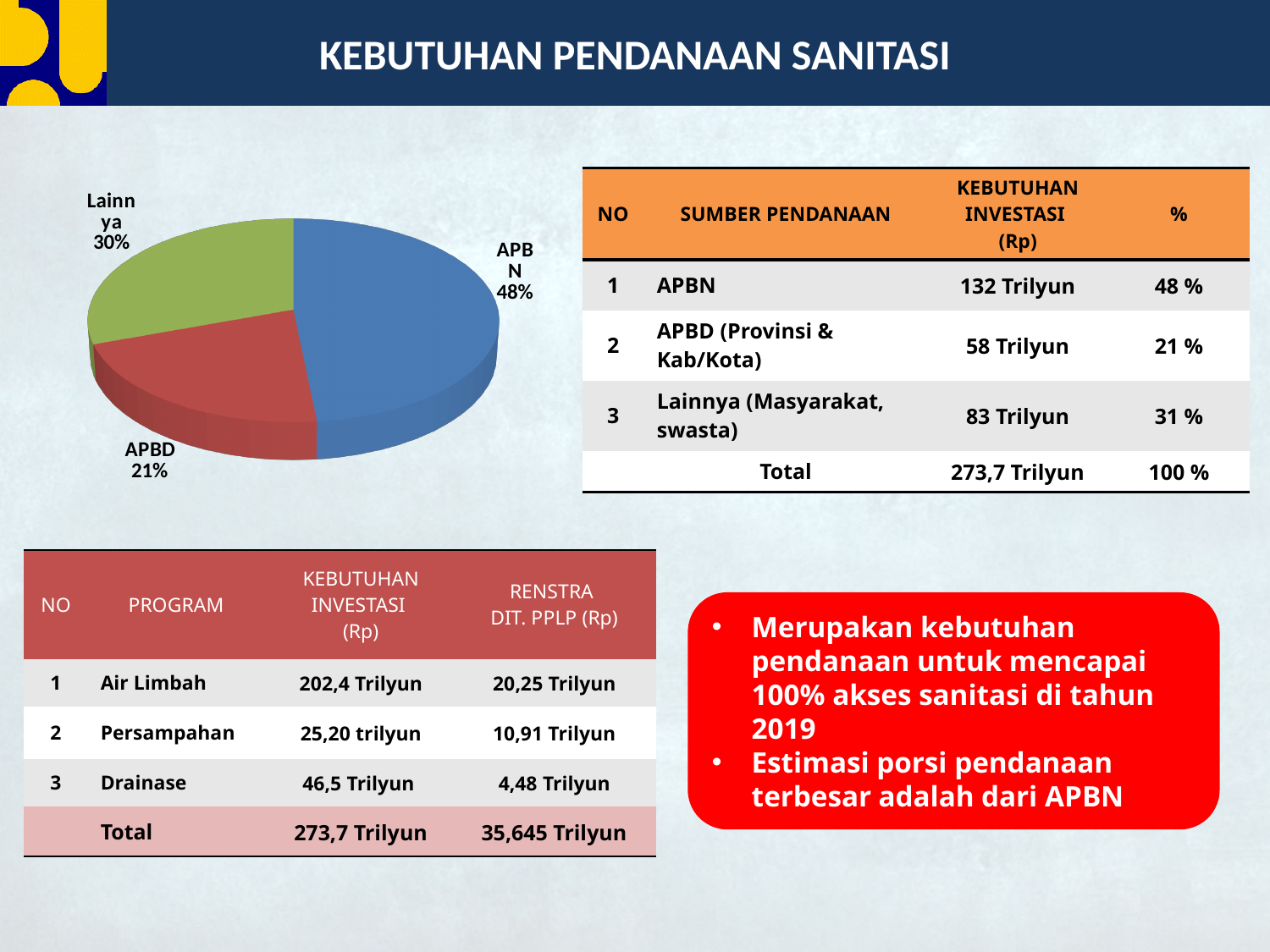
What percentage does the pie chart show for Lainnya? 30% What kind of chart is shown on the slide? pie chart How many slices does the pie chart have? 3 What percentage does the pie chart show for APBN? 48% Which slice of the pie chart is the largest? APBN Which slice of the pie chart is the smallest? APBD In the pie chart, which is larger, the APBD slice or the Lainnya slice? Lainnya What colour is the Lainnya slice in the pie chart? green What percentage does the pie chart show for APBD? 21% What is the difference in percentage points between the APBN slice and the APBD slice in the pie chart? 27 What colour is the APBN slice in the pie chart? blue What is the difference in percentage points between the APBN slice and the Lainnya slice in the pie chart? 18